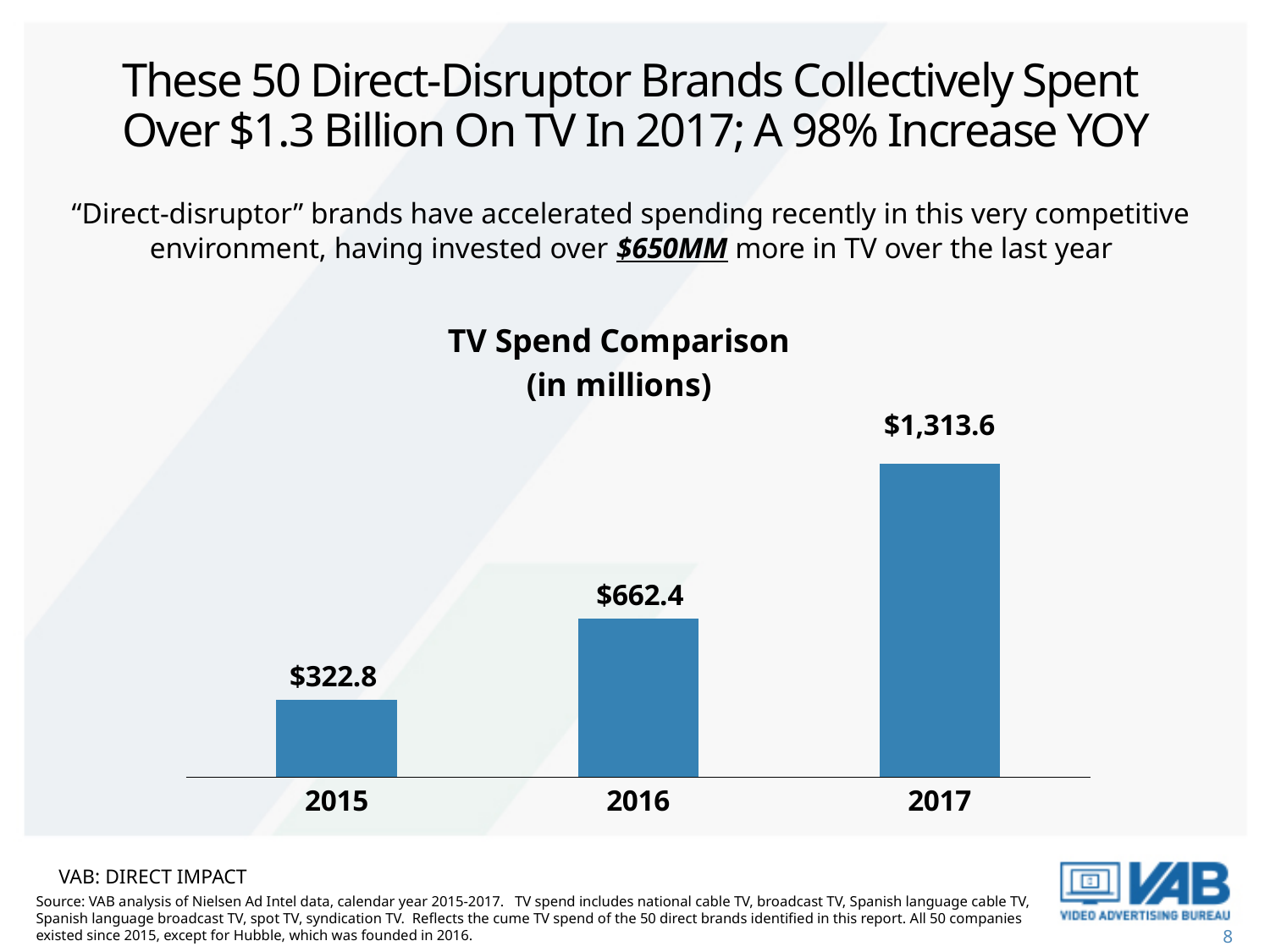
What is the difference in TV spend between 2016 and 2015? $339.6 Which year has the lowest TV spend? 2015 What is the TV spend value shown for 2017? $1,313.6 What is the difference in TV spend between 2017 and 2016? $651.2 What type of chart is shown on the slide? Bar chart What is the title of the chart? TV Spend Comparison (in millions) How many years are shown on the chart? 3 What is the TV spend value shown for 2016? $662.4 Which year has a larger TV spend, 2015 or 2016? 2016 What is the TV spend value shown for 2015? $322.8 Do the TV spend values rise or fall from 2015 to 2017? Rise Which year has the highest TV spend? 2017